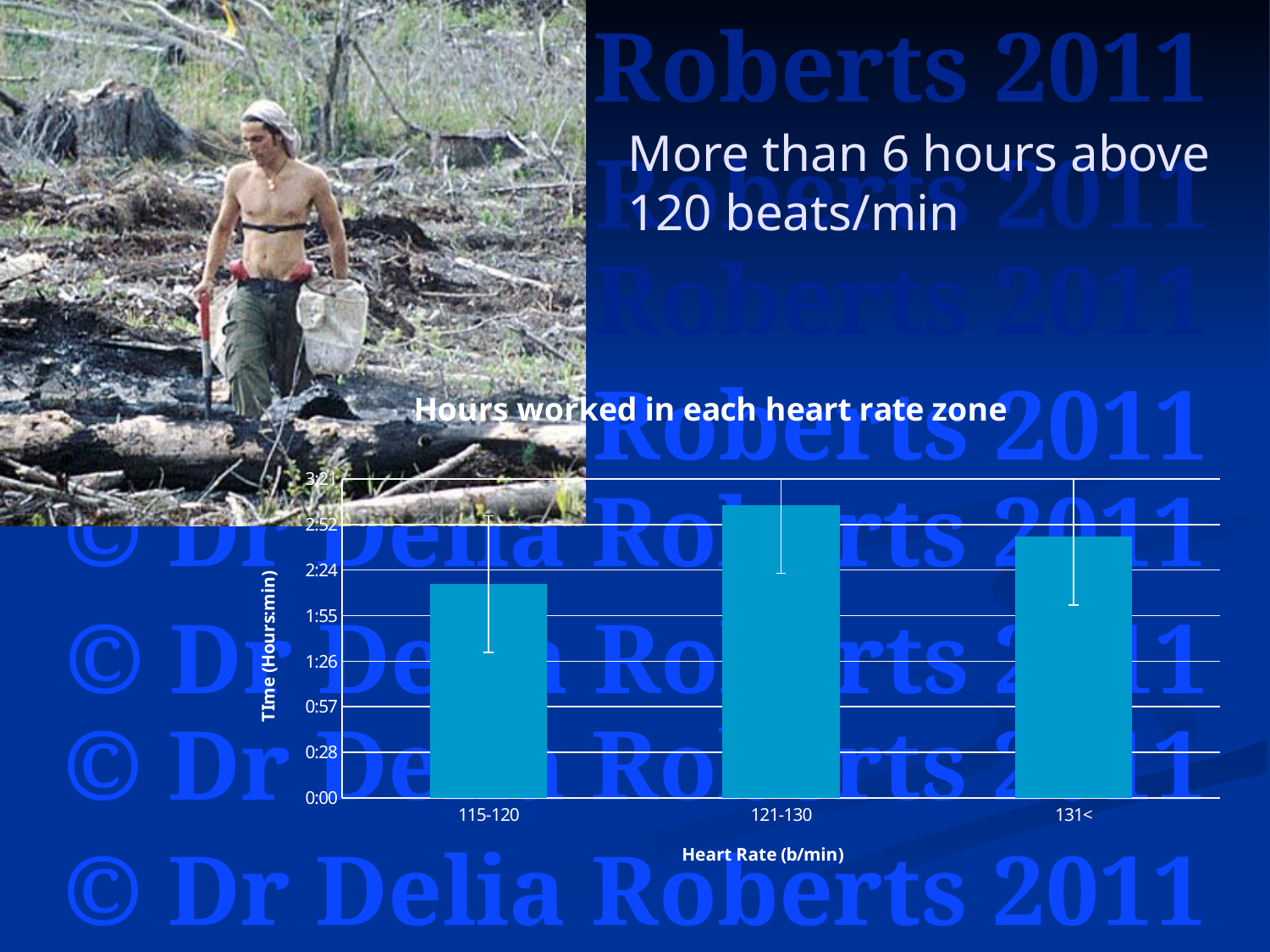
What kind of chart is shown on the slide? bar chart Which heart rate zone has the highest bar? 121-130 Is the value for 115-120 greater or less than 1:55? greater How many heart rate zones are plotted on the x axis? 3 Which bar is taller, 121-130 or 131<? 121-130 What is the title of the chart? Hours worked in each heart rate zone What is the label of the x axis? Heart Rate (b/min) Which heart rate zone has the lowest bar? 115-120 Which bar is taller, 115-120 or 131<? 131< Is the value for 121-130 greater or less than 2:24? greater Is the value for 131< greater or less than 2:24? greater